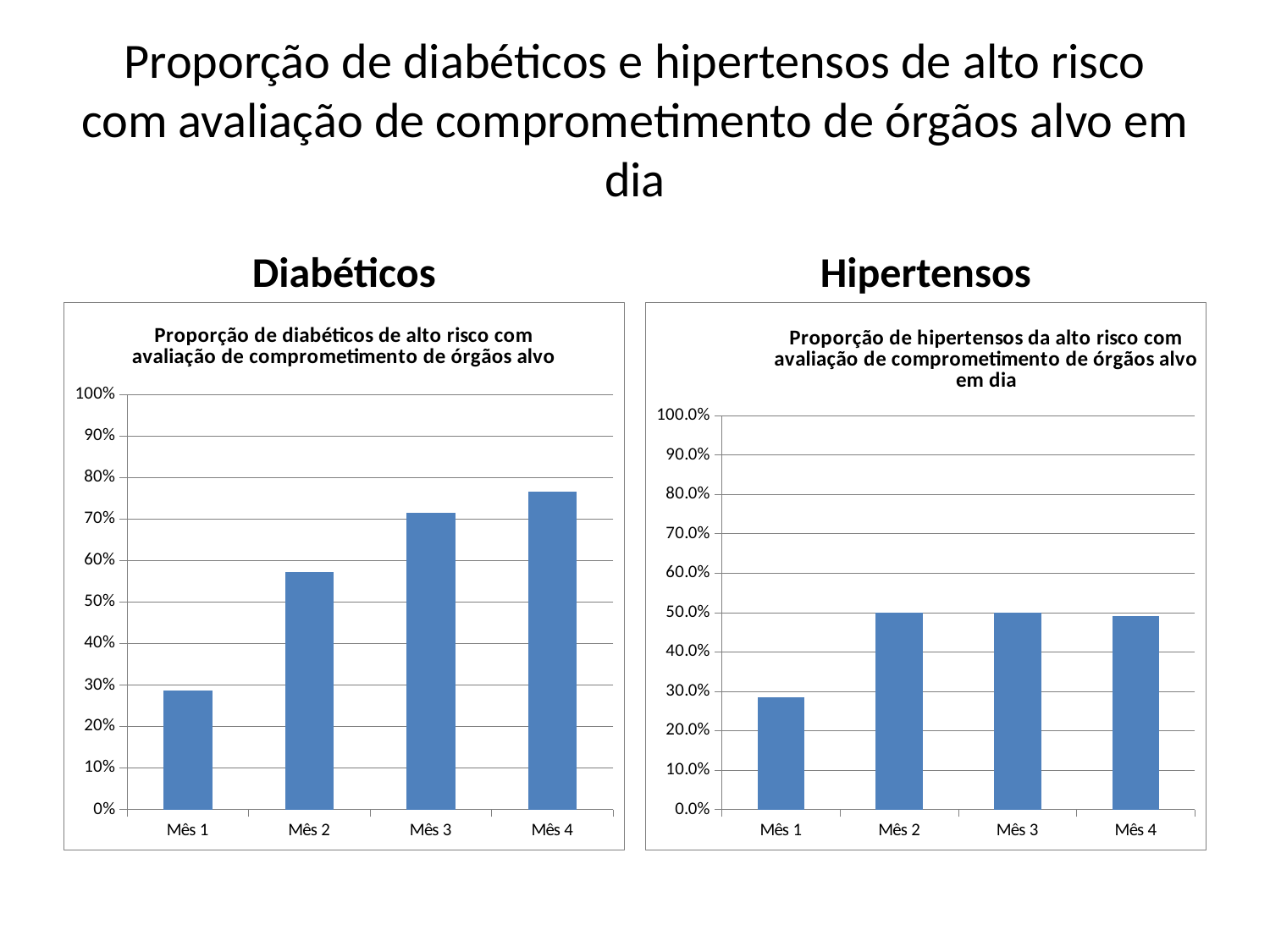
In the Diabéticos chart, is the value for Mês 1 greater or less than 30%? less How many months are shown on the x axis of the Diabéticos chart? 4 In the Diabéticos chart, do the values rise or fall from Mês 1 to Mês 4? rise What kind of chart is the Diabéticos chart? bar chart In the Diabéticos chart, which month has the lowest value? Mês 1 In the Hipertensos chart, which is larger, the value for Mês 1 or the value for Mês 2? Mês 2 In the Hipertensos chart, is the value for Mês 3 greater or less than 40.0%? greater In the Diabéticos chart, is the value for Mês 4 greater or less than 70%? greater In the Hipertensos chart, which month has the lowest value? Mês 1 What is the title printed inside the Hipertensos chart? Proporção de hipertensos da alto risco com avaliação de comprometimento de órgãos alvo em dia In the Diabéticos chart, which month has the highest value? Mês 4